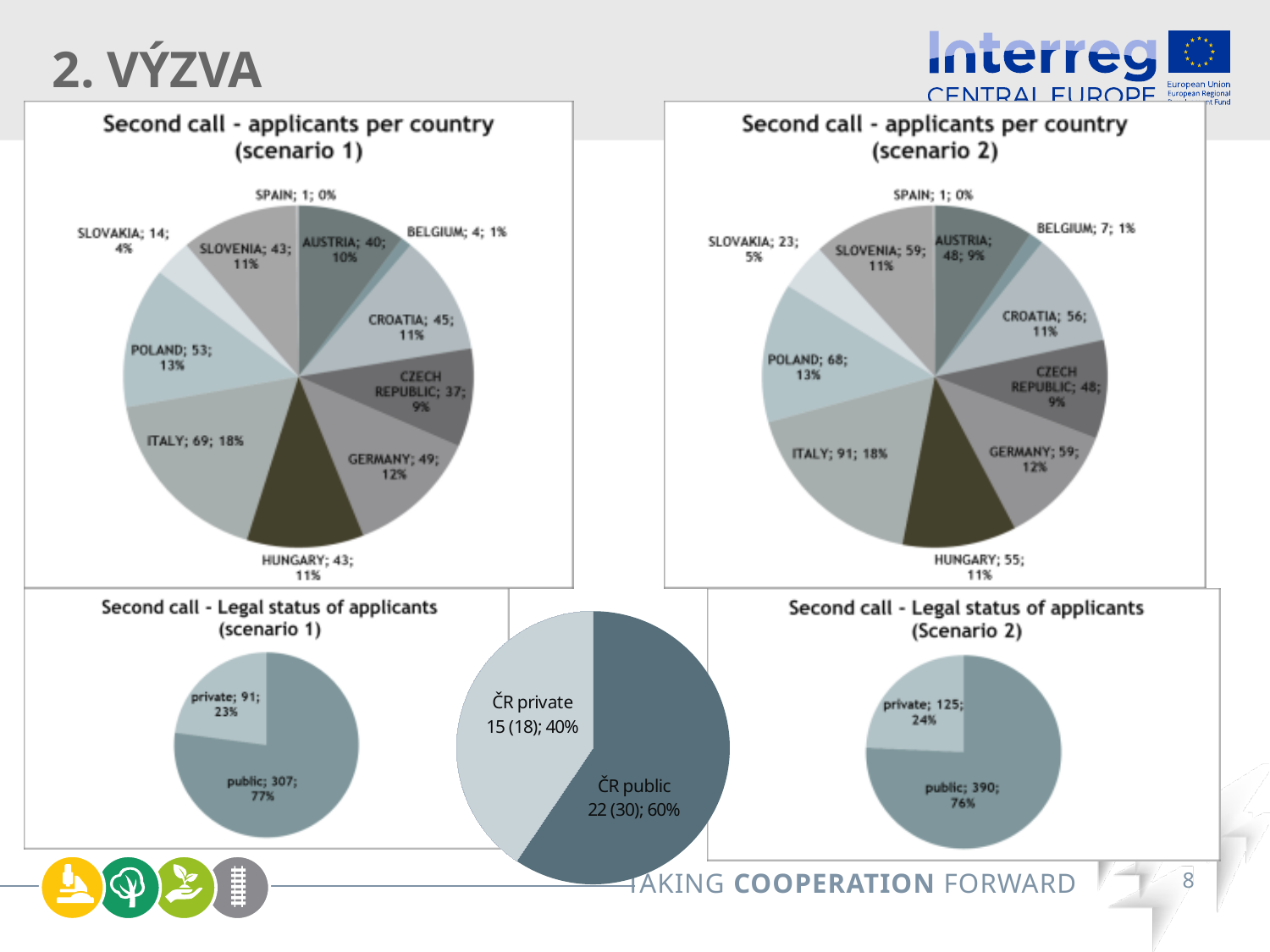
In the 'Second call - Legal status of applicants (scenario 1)' chart, how many public applicants are there? 307 What type of chart is used for 'Second call - Legal status of applicants (Scenario 2)'? Pie chart How many countries are shown in the 'Second call - applicants per country (scenario 2)' chart? 11 In the 'Second call - applicants per country (scenario 1)' chart, how many applicants are from Italy? 69 In the untitled pie chart at the bottom centre of the slide, what share is labelled 'ČR public'? 60% In the 'Second call - applicants per country (scenario 2)' chart, what share of applicants is from Germany? 12% In the 'Second call - applicants per country (scenario 1)' chart, which country has the fewest applicants? Spain In the 'Second call - applicants per country (scenario 1)' chart, which has more applicants, Germany or Croatia? Germany In the 'Second call - applicants per country (scenario 1)' chart, which country has the most applicants? Italy In the 'Second call - applicants per country (scenario 2)' chart, what is the difference between the number of applicants from Italy and from Hungary? 36 In the 'Second call - Legal status of applicants (Scenario 2)' chart, what share of applicants is private? 24% In the 'Second call - applicants per country (scenario 2)' chart, how many applicants are from Poland? 68